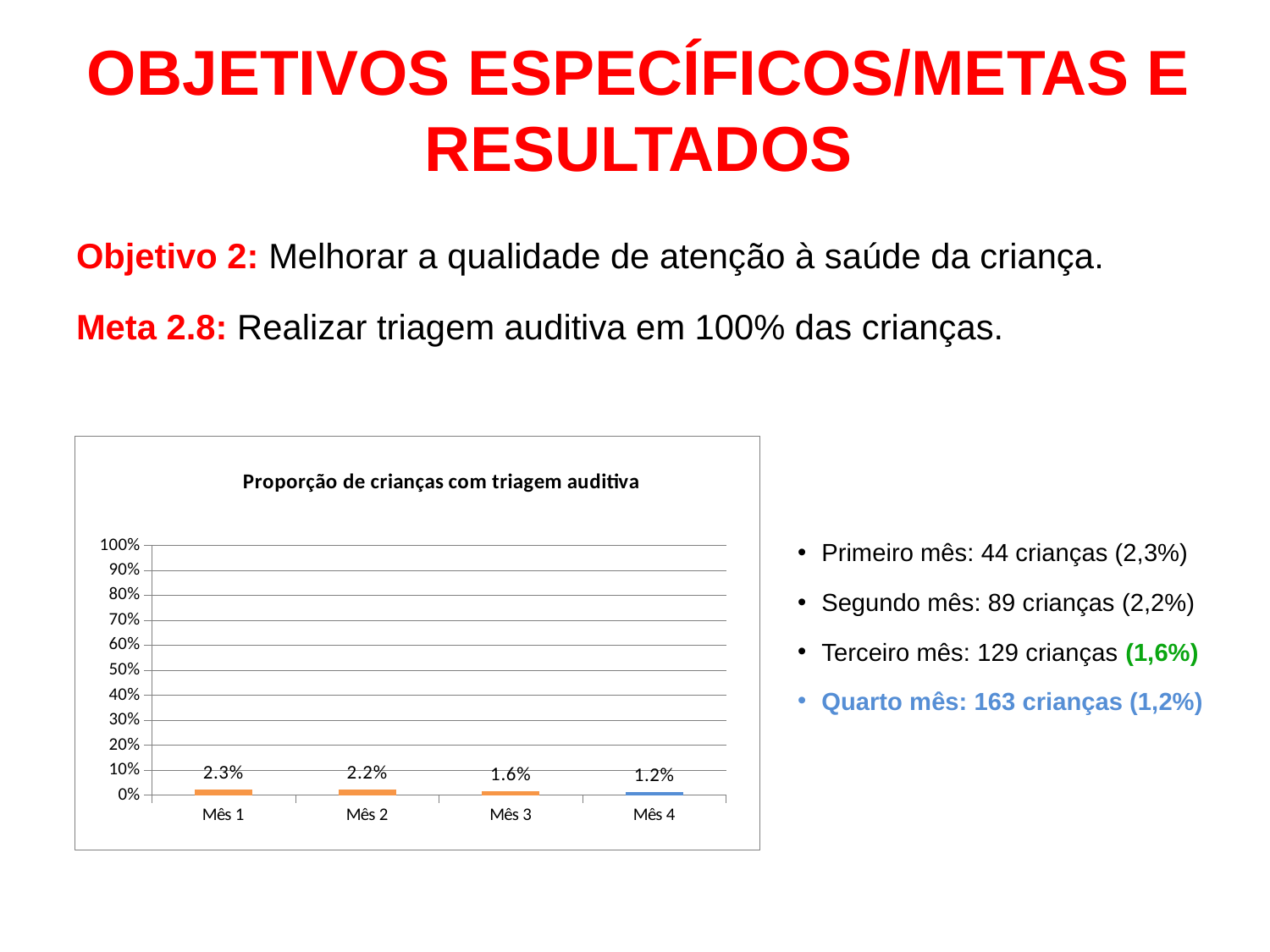
How many months are shown on the x axis of the chart? 4 Do the values rise or fall from Mês 1 to Mês 4? fall What is the value for Mês 1 in the chart? 2.3% What is the value for Mês 4 in the chart? 1.2% Which is larger, the value for Mês 2 or the value for Mês 3? Mês 2 What kind of chart is shown on the slide? bar chart What is the difference between the values for Mês 1 and Mês 4? 1.1% Which month has the highest proportion of children with hearing screening? Mês 1 Is the value for Mês 2 greater or less than 10%? less What is the value for Mês 3 in the chart? 1.6% Which month has the lowest proportion of children with hearing screening? Mês 4 What is the title of the chart? Proporção de crianças com triagem auditiva